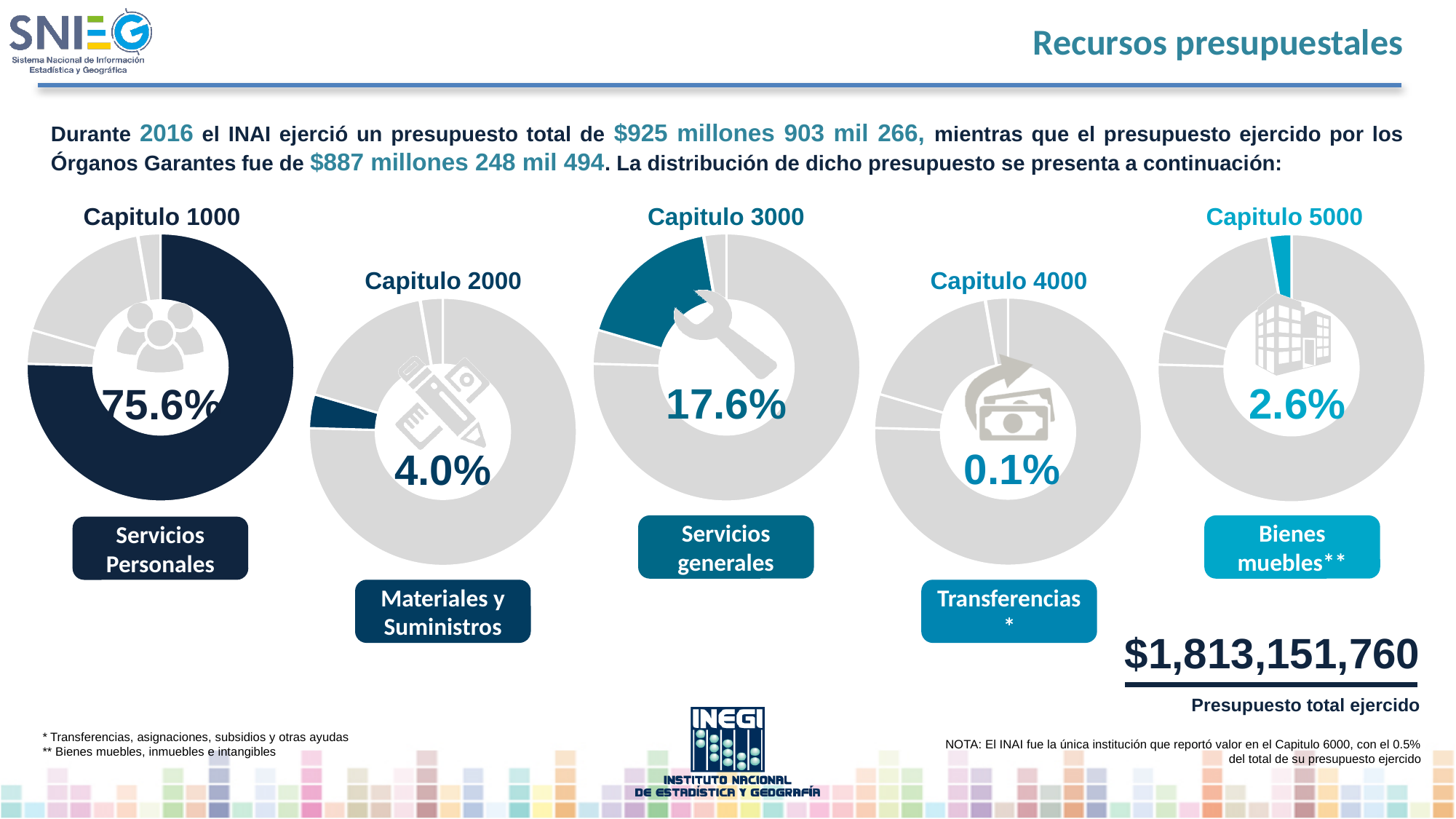
Across the five donut charts, which Capitulo has the highest percentage? Capitulo 1000 How many donut charts are shown on the slide? 5 Which has a larger share, Capitulo 2000 or Capitulo 5000? Capitulo 2000 In the Capitulo 2000 chart, what percentage is shown for Materiales y Suministros? 4.0% In the Capitulo 4000 chart, what percentage is shown for Transferencias? 0.1% In the Capitulo 5000 chart, what percentage is shown for Bienes muebles? 2.6% What label appears in the box below the Capitulo 3000 chart? Servicios generales What kind of chart is used to show the share for each Capitulo? Donut (pie) chart Across the five donut charts, which Capitulo has the lowest percentage? Capitulo 4000 What is the difference in percentage points between the Capitulo 1000 share and the Capitulo 3000 share? 58.0% In the Capitulo 3000 chart, what percentage is shown for Servicios generales? 17.6% In the Capitulo 1000 chart, what percentage is shown for Servicios Personales? 75.6%